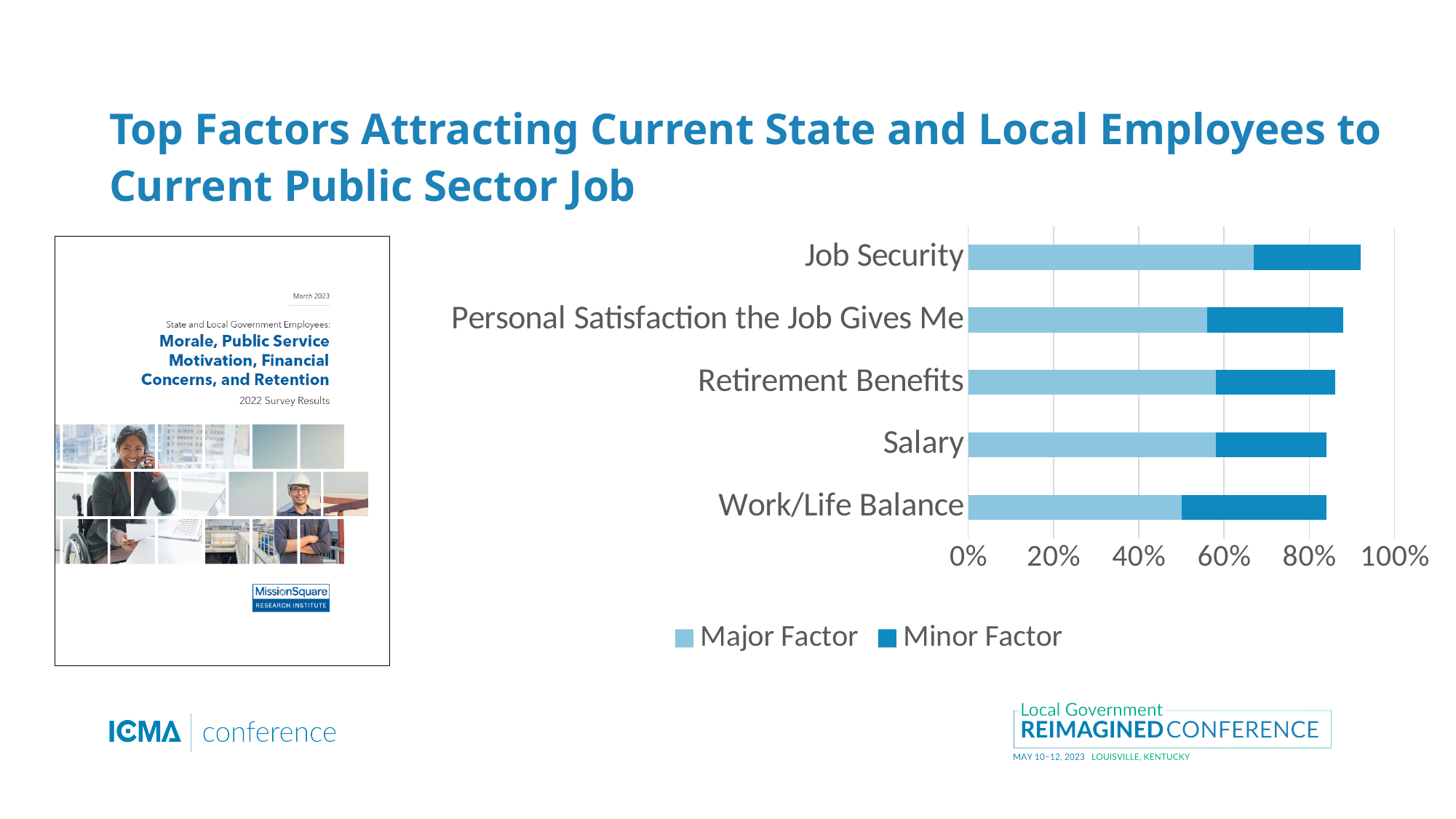
Which has the larger Major Factor segment: Job Security or Work/Life Balance? Job Security How many series does the chart legend list? 2 Which factor has the longest total bar in the chart? Job Security What are the two series named in the chart legend? Major Factor and Minor Factor Which has the larger Minor Factor segment: Work/Life Balance or Job Security? Work/Life Balance How many factors (categories) are plotted in the chart? 5 What kind of chart is shown on the slide? Stacked bar chart Is the total bar (Major plus Minor Factor) for Job Security greater or less than 80%? greater Is the Major Factor value for Work/Life Balance greater or less than 60%? less Which factor has the largest Major Factor segment? Job Security Which factor has the smallest Major Factor segment? Work/Life Balance Is the Major Factor value for Job Security greater or less than 60%? greater